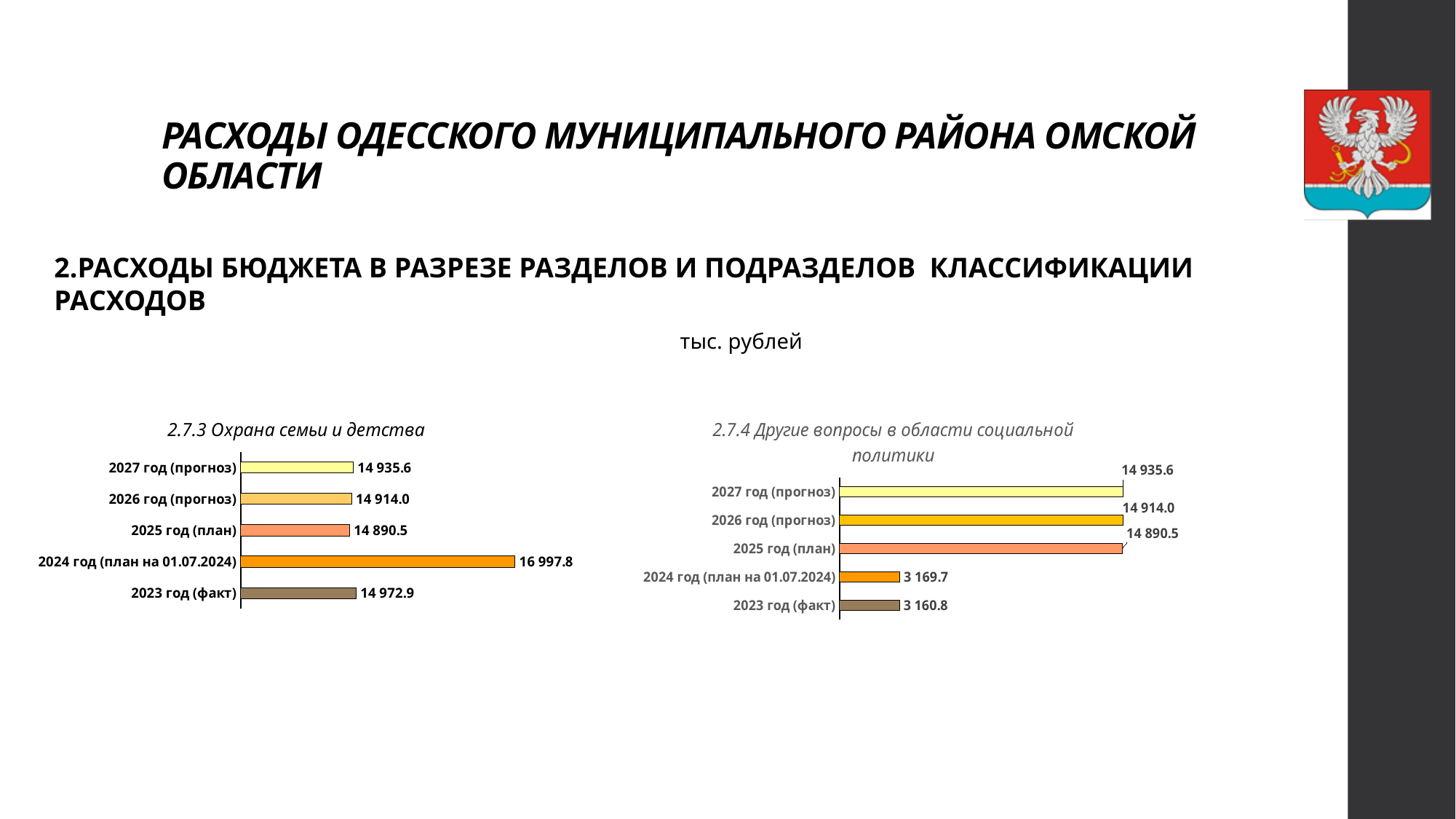
In the chart '2.7.3 Охрана семьи и детства', which category has the highest value? 2024 год (план на 01.07.2024) How many categories are shown in the chart '2.7.3 Охрана семьи и детства'? 5 In the chart '2.7.3 Охрана семьи и детства', what is the difference between the values for 2024 год (план на 01.07.2024) and 2023 год (факт)? 2 024.9 In the chart '2.7.4 Другие вопросы в области социальной политики', what is the value for 2026 год (прогноз)? 14 914.0 In the chart '2.7.3 Охрана семьи и детства', what is the value for 2023 год (факт)? 14 972.9 In the chart '2.7.3 Охрана семьи и детства', which category has the lowest value? 2025 год (план) What type of chart is '2.7.4 Другие вопросы в области социальной политики'? Bar chart In the chart '2.7.4 Другие вопросы в области социальной политики', which is larger: the value for 2025 год (план) or 2024 год (план на 01.07.2024)? 2025 год (план) In the chart '2.7.4 Другие вопросы в области социальной политики', what is the difference between the values for 2024 год (план на 01.07.2024) and 2023 год (факт)? 8.9 In the chart '2.7.3 Охрана семьи и детства', what is the value for 2024 год (план на 01.07.2024)? 16 997.8 In the chart '2.7.4 Другие вопросы в области социальной политики', which category has the lowest value? 2023 год (факт) In the chart '2.7.4 Другие вопросы в области социальной политики', what is the value for 2023 год (факт)? 3 160.8